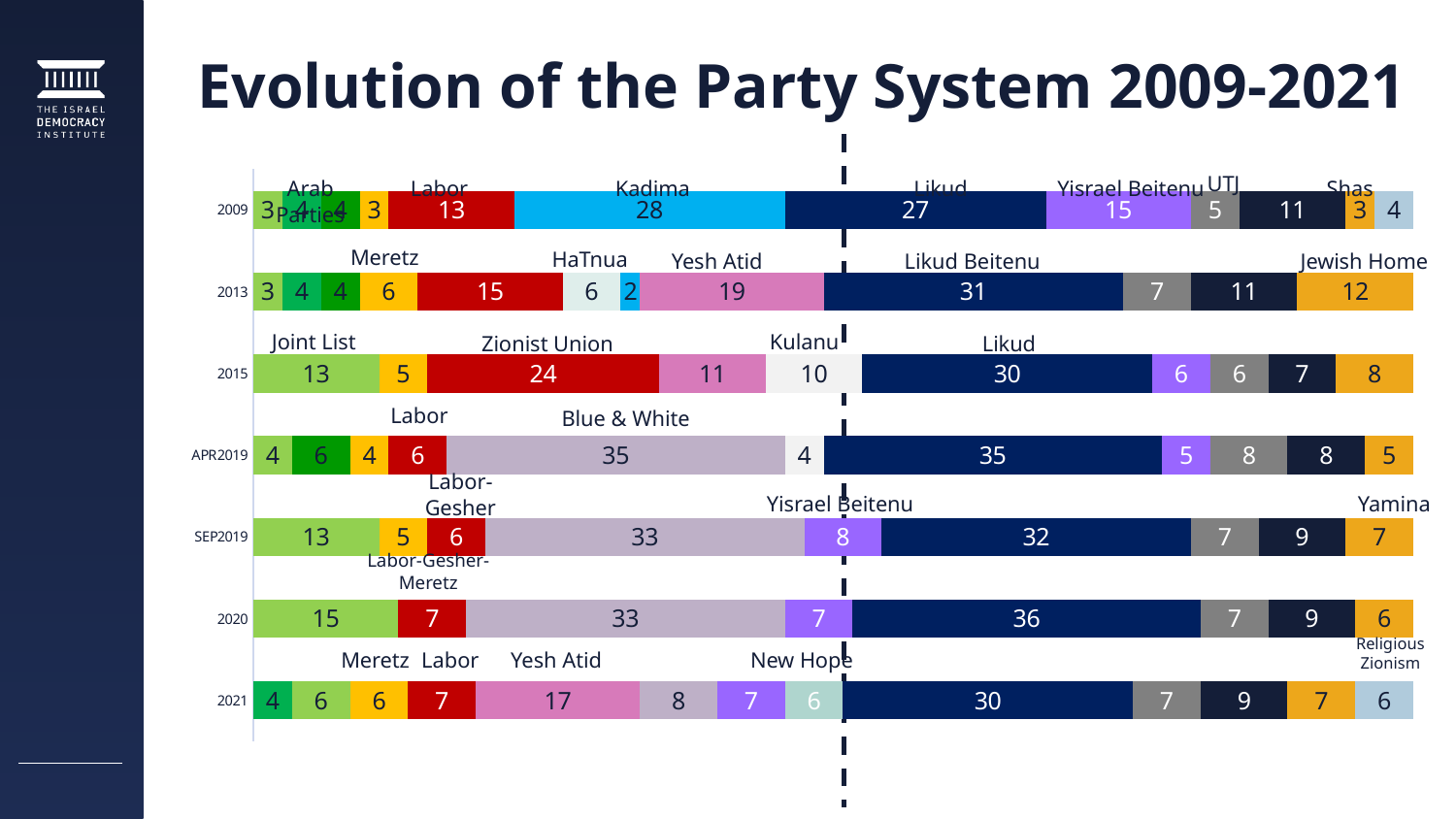
How many seats did Yesh Atid win in 2021? 17 What kind of chart is shown on the slide? Stacked bar chart In which election year did Likud win its highest number of seats shown on the chart? 2020 How many more seats did Likud win in 2020 than in 2021? 6 Which had more seats in 2015, the Joint List or Kulanu? Joint List What is the title of the slide? Evolution of the Party System 2009-2021 What is the difference between Kadima's and Likud's seats in 2009? 1 How many seats did the Zionist Union win in 2015? 24 How many seats did Likud Beitenu win in 2013? 31 How many seats did Kadima win in 2009? 28 How many seats did Blue & White win in the April 2019 election? 35 How many election rows are shown on the chart? 7